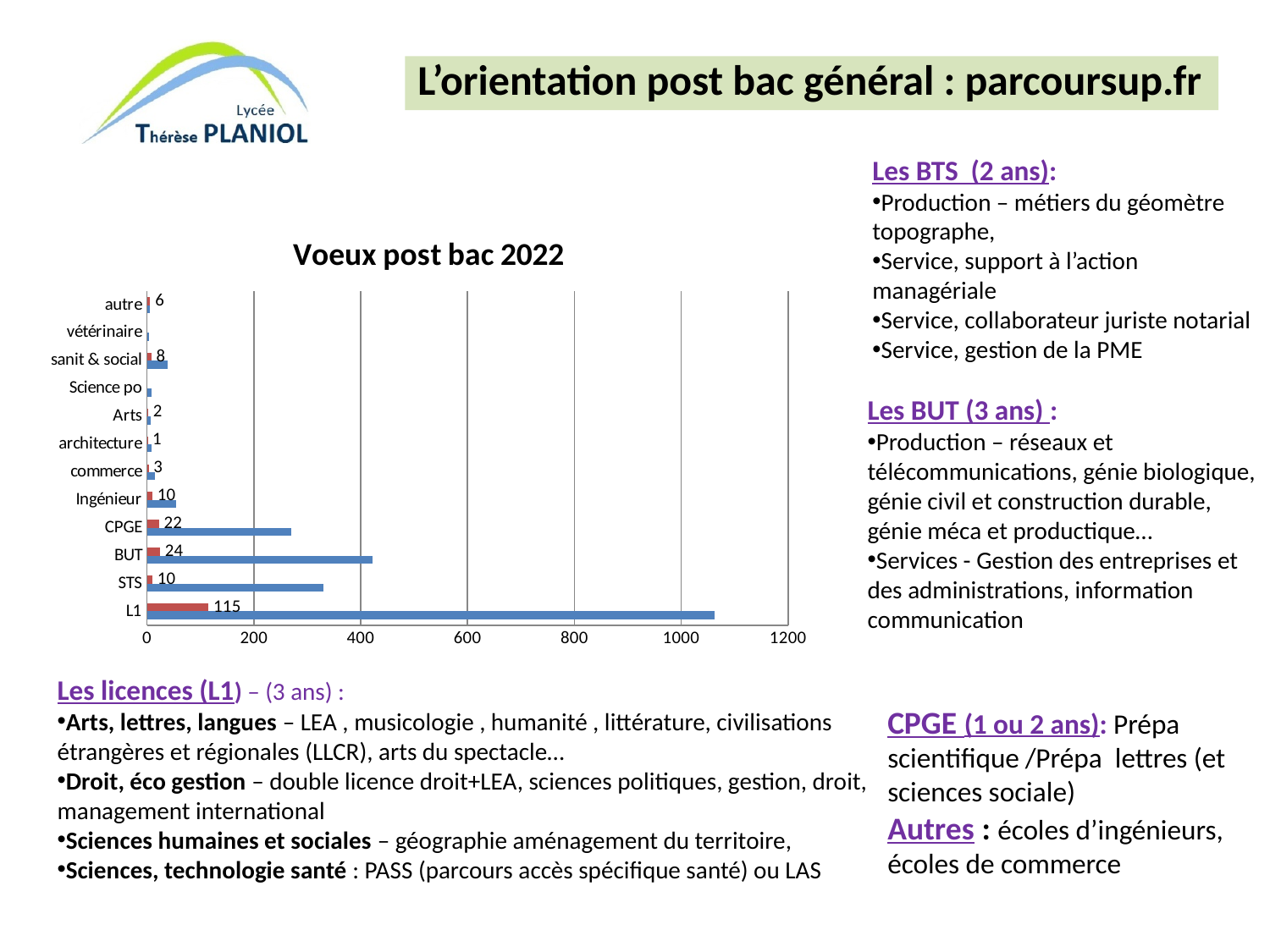
What is the title of the chart? Voeux post bac 2022 What kind of chart is shown on the slide? bar chart How many categories are shown on the vertical axis of the chart? 12 What value is labelled on the red bar for BUT? 24 What value is labelled on the red bar for CPGE? 22 What is the difference between the labelled values for BUT and CPGE? 2 What is the difference between the labelled values for L1 and BUT? 91 What value is labelled on the red bar for L1? 115 Is the value of the blue bar for L1 greater or less than 1000? greater Which category has the highest labelled value on the red bars? L1 What value is labelled on the red bar for architecture? 1 Which has the larger labelled value, Ingénieur or commerce? Ingénieur